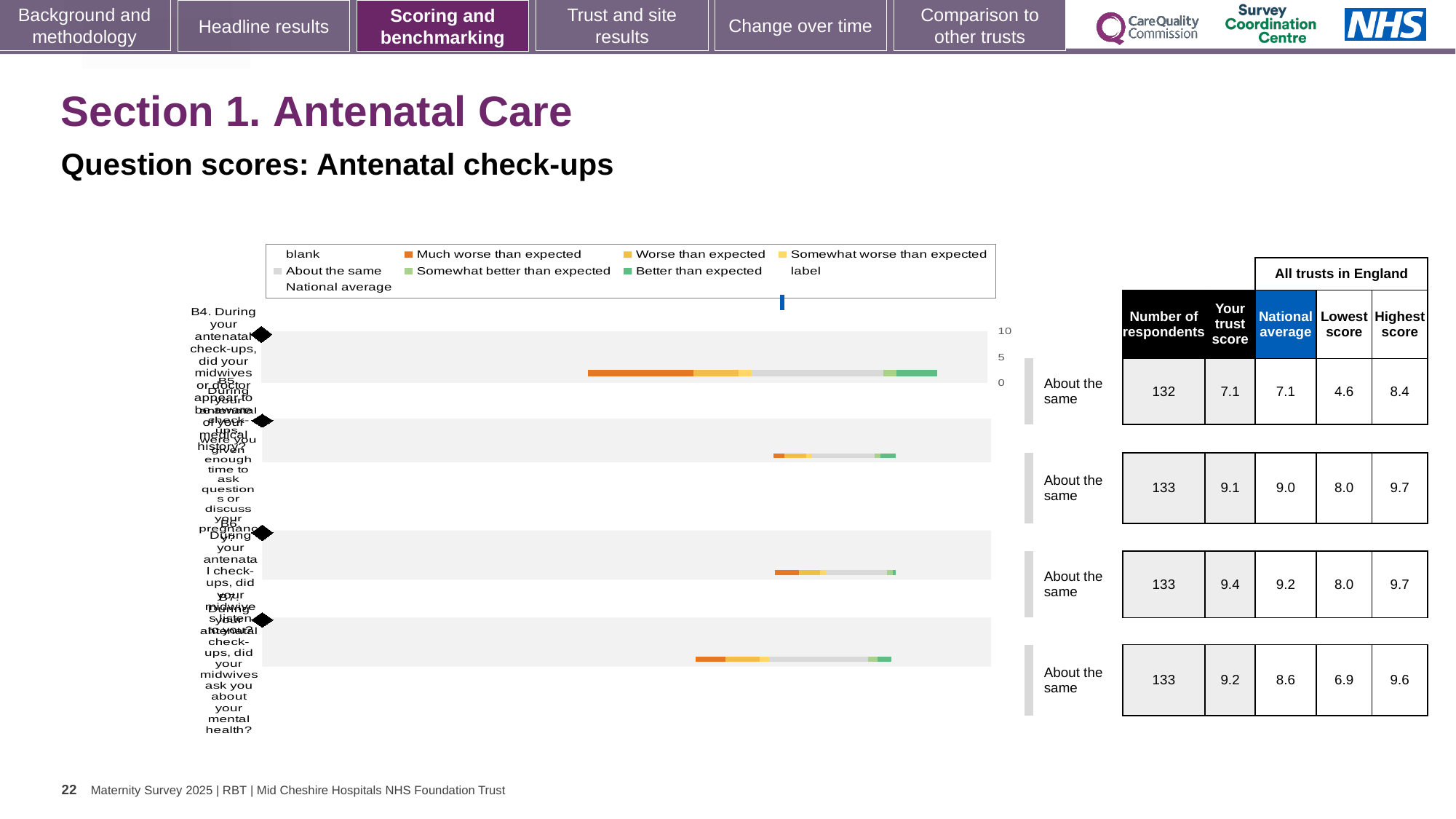
For the bottom row (fourth question), what is the difference between the trust score and the national average? 0.6 For the second row, which is larger: the trust score or the national average? The trust score (9.1) What is the national average for the bottom row (fourth question)? 8.6 How many questions (bars) are plotted in the chart? 4 What benchmark category is shown for all four questions? About the same What kind of chart is shown on the slide? Bar chart What is the trust score for question B4 (the top row)? 7.1 What is the highest score across all trusts in England for question B4 (the top row)? 8.4 What is the lowest score across all trusts in England for the bottom row (fourth question)? 6.9 Which row has the highest trust score? The third row (9.4) What is the number of respondents for question B4 (the top row)? 132 Which row has the lowest trust score? B4, the top row (7.1)